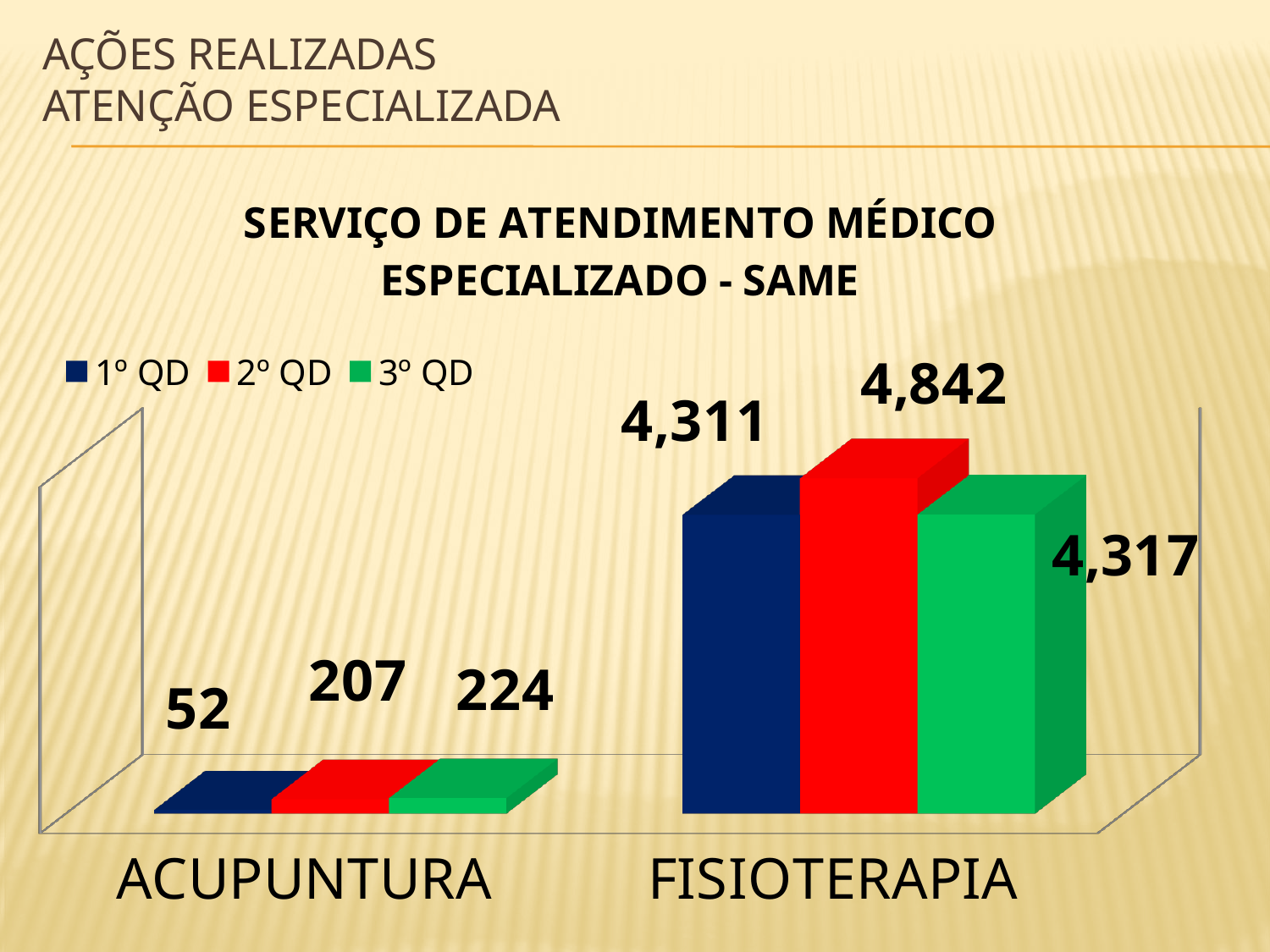
What is the value for 1º QD in the ACUPUNTURA category? 52 How many categories are shown on the x axis? 2 Which series has the highest value in the FISIOTERAPIA category? 2º QD What is the difference between the 3º QD and 2º QD values for ACUPUNTURA? 17 What is the difference between the 2º QD and 1º QD values for FISIOTERAPIA? 531 What is the value for 1º QD in the FISIOTERAPIA category? 4,311 What is the value for 2º QD in the FISIOTERAPIA category? 4,842 Which is larger for 3º QD: ACUPUNTURA or FISIOTERAPIA? FISIOTERAPIA What is the value for 3º QD in the ACUPUNTURA category? 224 How many series does the legend list? 3 What kind of chart is shown on the slide? Bar chart Which series has the lowest value in the ACUPUNTURA category? 1º QD